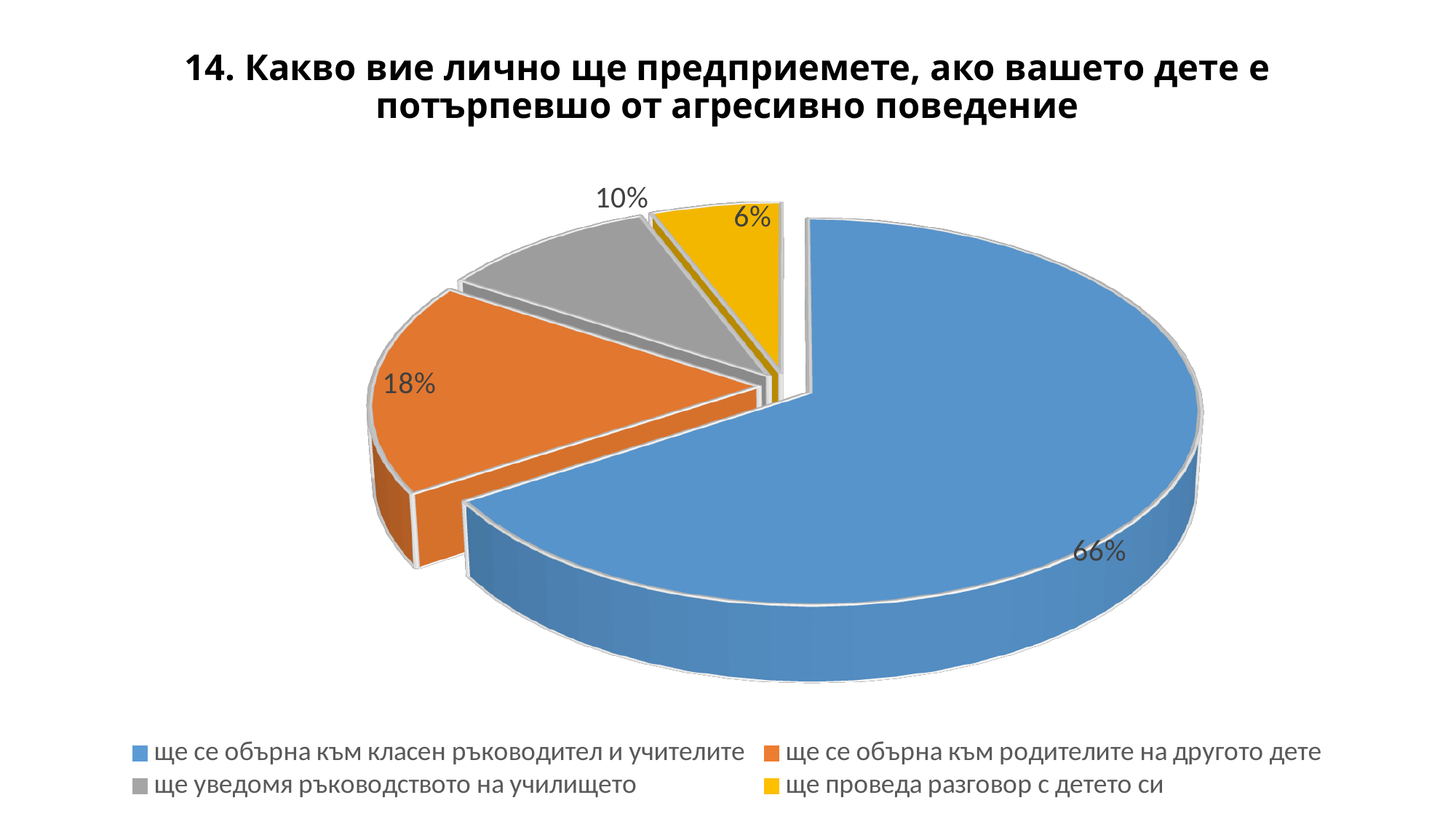
What share of the pie is labelled "ще се обърна към класен ръководител и учителите"? 66% What colour is the slice for "ще проведа разговор с детето си"? yellow What share of the pie is labelled "ще проведа разговор с детето си"? 6% How many slices does the pie chart have? 4 Which category has the largest slice of the pie? ще се обърна към класен ръководител и учителите What is the title of the chart? 14. Какво вие лично ще предприемете, ако вашето дете е потърпевшо от агресивно поведение What is the difference in percentage points between the slice for "ще се обърна към родителите на другото дете" and the slice for "ще уведомя ръководството на училището"? 8 What share of the pie is labelled "ще се обърна към родителите на другото дете"? 18% What share of the pie is labelled "ще уведомя ръководството на училището"? 10% What kind of chart is shown on the slide? pie chart Which category has the smallest slice of the pie? ще проведа разговор с детето си Which is larger: the slice for "ще уведомя ръководството на училището" or the slice for "ще проведа разговор с детето си"? ще уведомя ръководството на училището